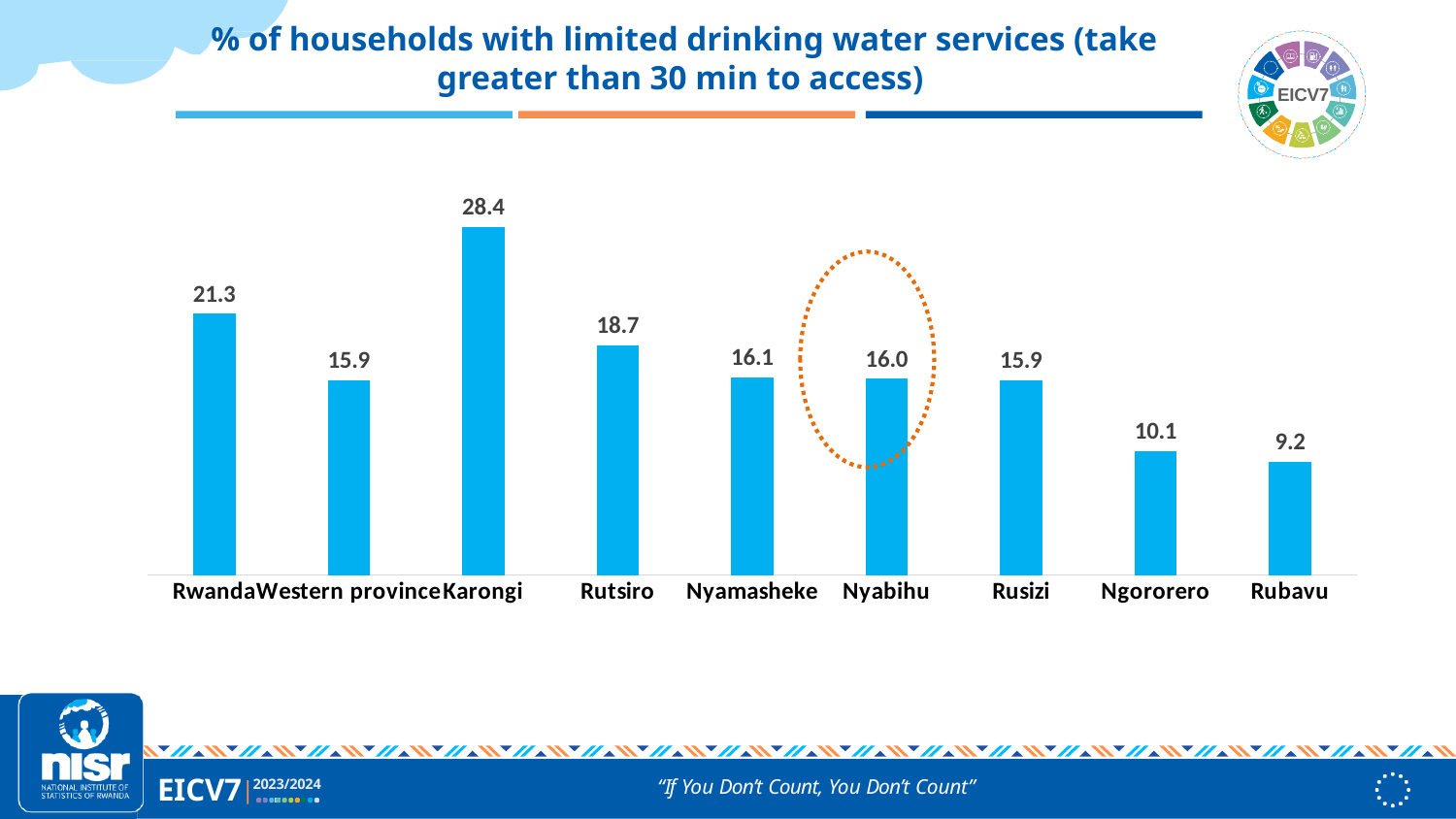
Which is larger, the value for Rutsiro or the value for Rusizi? Rutsiro What is the value for Rubavu? 9.2 What kind of chart is shown on the slide? Bar chart Which category has the highest value? Karongi What is the difference between the values for Ngororero and Rubavu? 0.9 What is the value for Nyabihu? 16.0 What is the value for Rwanda? 21.3 How many categories are shown on the x axis? 9 Which category has the lowest value? Rubavu Which category is highlighted with a dotted orange circle? Nyabihu What is the value for Karongi? 28.4 What is the difference between the values for Karongi and Rwanda? 7.1